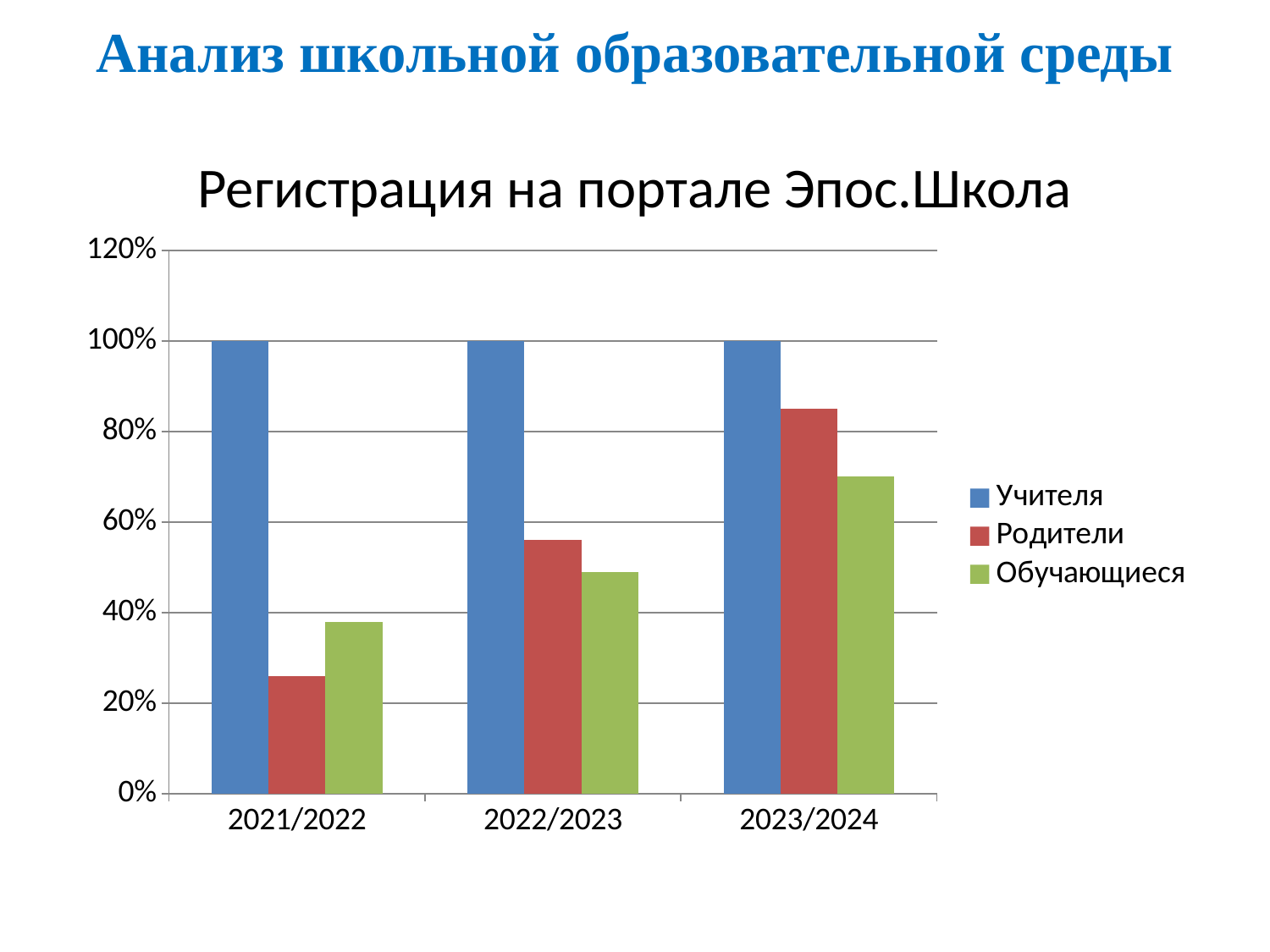
What is the title of the chart? Регистрация на портале Эпос.Школа Is the value for Обучающиеся in 2023/2024 greater or less than 60%? greater Is the value for Родители in 2023/2024 greater or less than 80%? greater How many series does the legend list? 3 What is the value for Учителя in 2023/2024? 100% Which is larger: Родители in 2022/2023 or Обучающиеся in 2022/2023? Родители in 2022/2023 How many school-year categories are shown on the x axis? 3 Do the values for Родители rise or fall from 2021/2022 to 2023/2024? rise Which series has the lowest value in 2022/2023? Обучающиеся What kind of chart is shown on the slide? bar chart Is the value for Родители in 2021/2022 greater or less than 40%? less Which series has the highest value in 2021/2022? Учителя